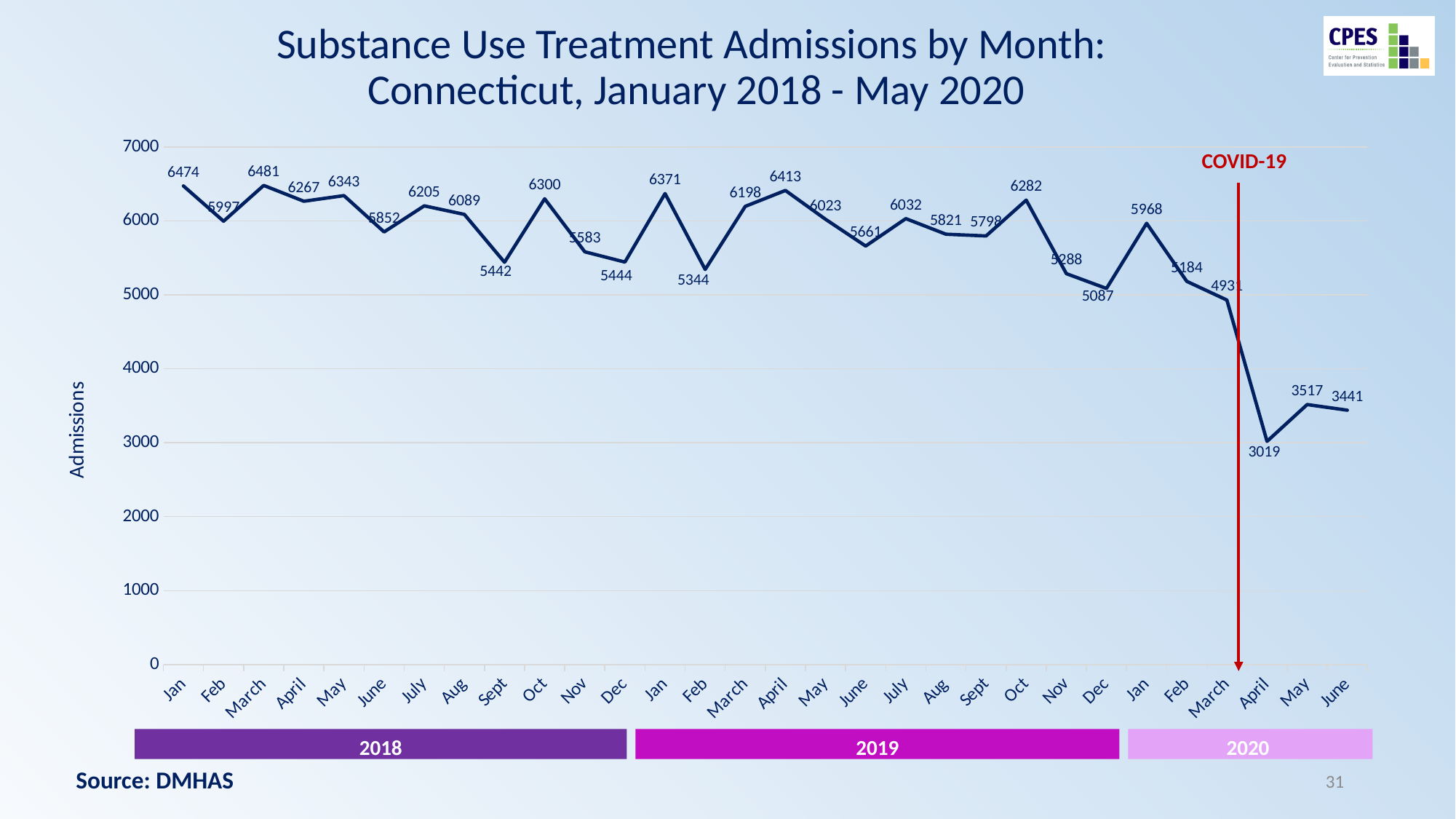
Which had more admissions, January 2019 or January 2020? January 2019 What kind of chart is shown on the slide? line chart How many monthly data points are plotted on the chart? 30 What is the difference in admissions between March 2020 and April 2020? 1912 Which month has the lowest number of admissions? April 2020 What was the number of admissions in January 2018? 6474 Is the value for May 2020 greater or less than 4000? less What was the number of admissions in April 2020? 3019 What was the number of admissions in October 2019? 6282 Which month has the highest number of admissions? March 2018 What event does the red vertical arrow on the chart mark? COVID-19 Do admissions rise or fall from March 2020 to April 2020? fall